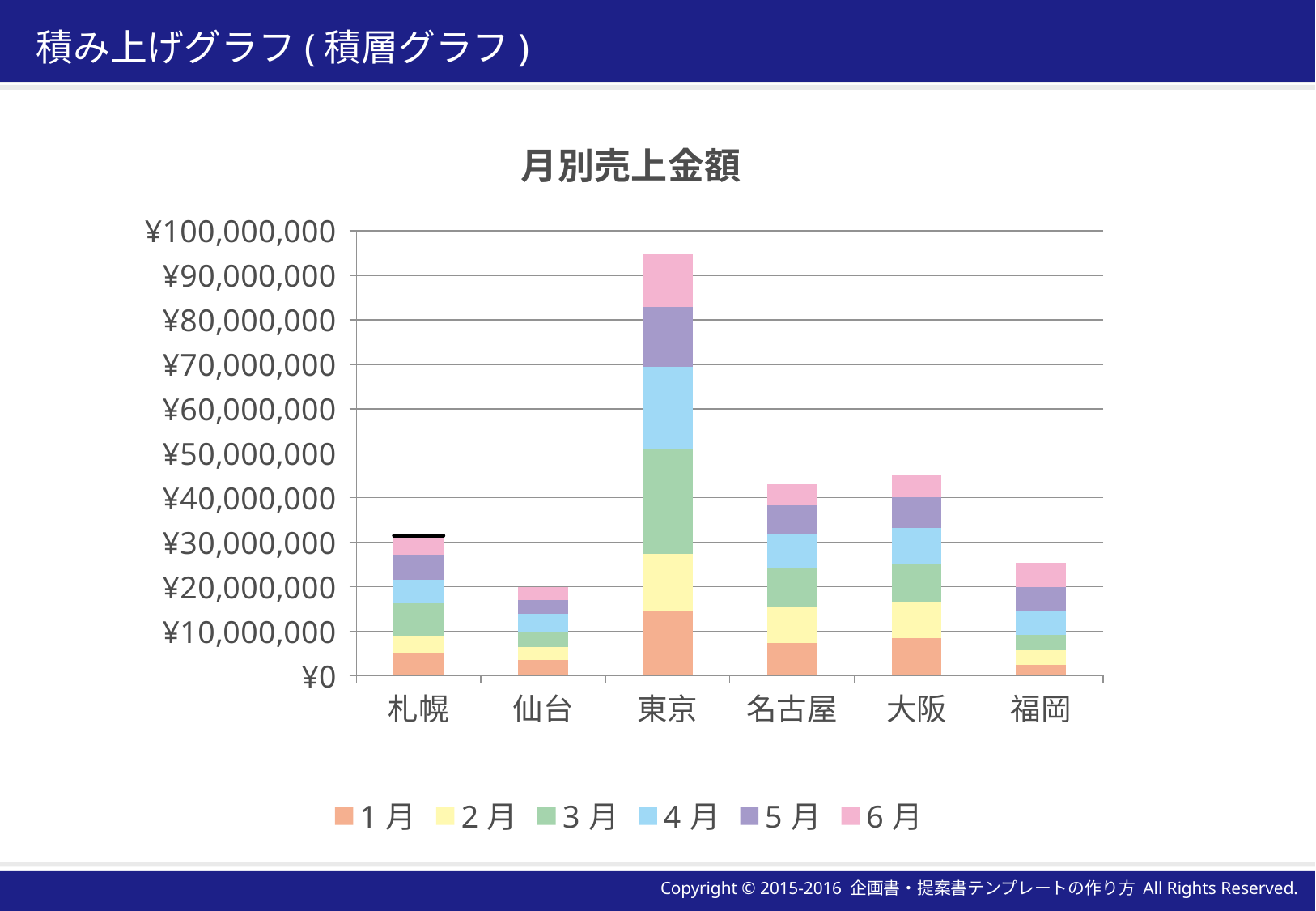
What is the title of the chart? 月別売上金額 Which legend entry is shown in pink, the top segment of each bar? 6月 Is the total value for 東京 greater or less than ¥90,000,000? greater Is the total value for 大阪 greater or less than ¥50,000,000? less What kind of chart is shown on the slide? Stacked bar chart How many cities (categories) are shown on the x axis? 6 How many series does the legend list? 6 Which has the larger total stacked bar, 札幌 or 福岡? 札幌 Is the total value for 名古屋 greater or less than ¥40,000,000? greater Which city has the lowest total stacked bar? 仙台 Which city has the highest total stacked bar? 東京